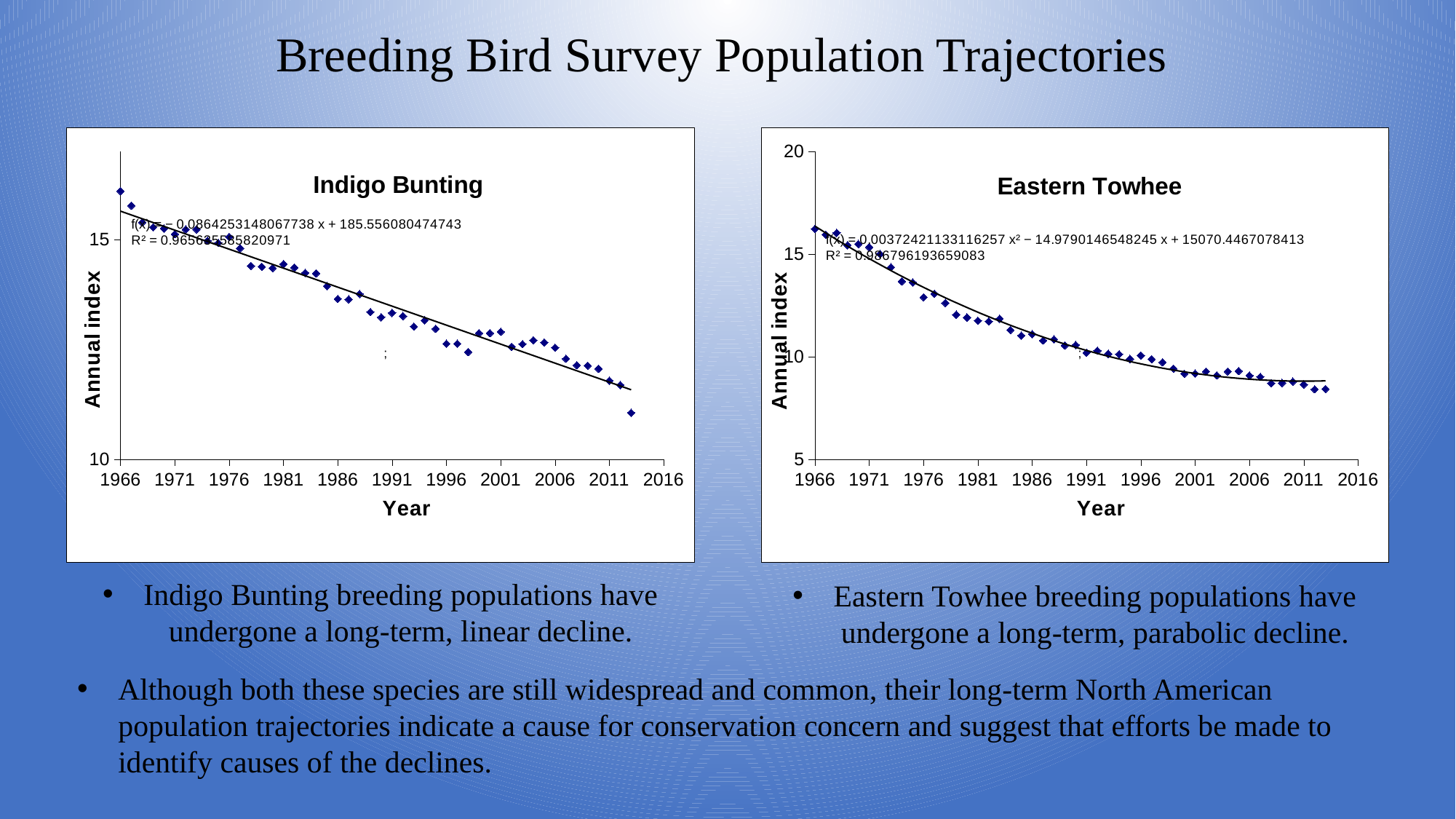
What is the label of the vertical axis in the Eastern Towhee chart? Annual index In the Indigo Bunting chart, do the annual index values rise or fall from 1966 to 2016? fall In the Eastern Towhee chart, is the annual index value for 1966 greater or less than 15? greater In the Indigo Bunting chart, is the annual index value for 1966 greater or less than 15? greater In the Indigo Bunting chart, is the annual index value for 1996 greater or less than 15? less In the Indigo Bunting chart, is the annual index value for 1966 greater or less than the value for 2011? greater What is the title of the chart on the left side of the slide? Indigo Bunting In the Eastern Towhee chart, do the annual index values rise or fall over the years shown? fall What kind of chart is the Eastern Towhee chart? scatter chart What kind of chart is the Indigo Bunting chart? scatter chart